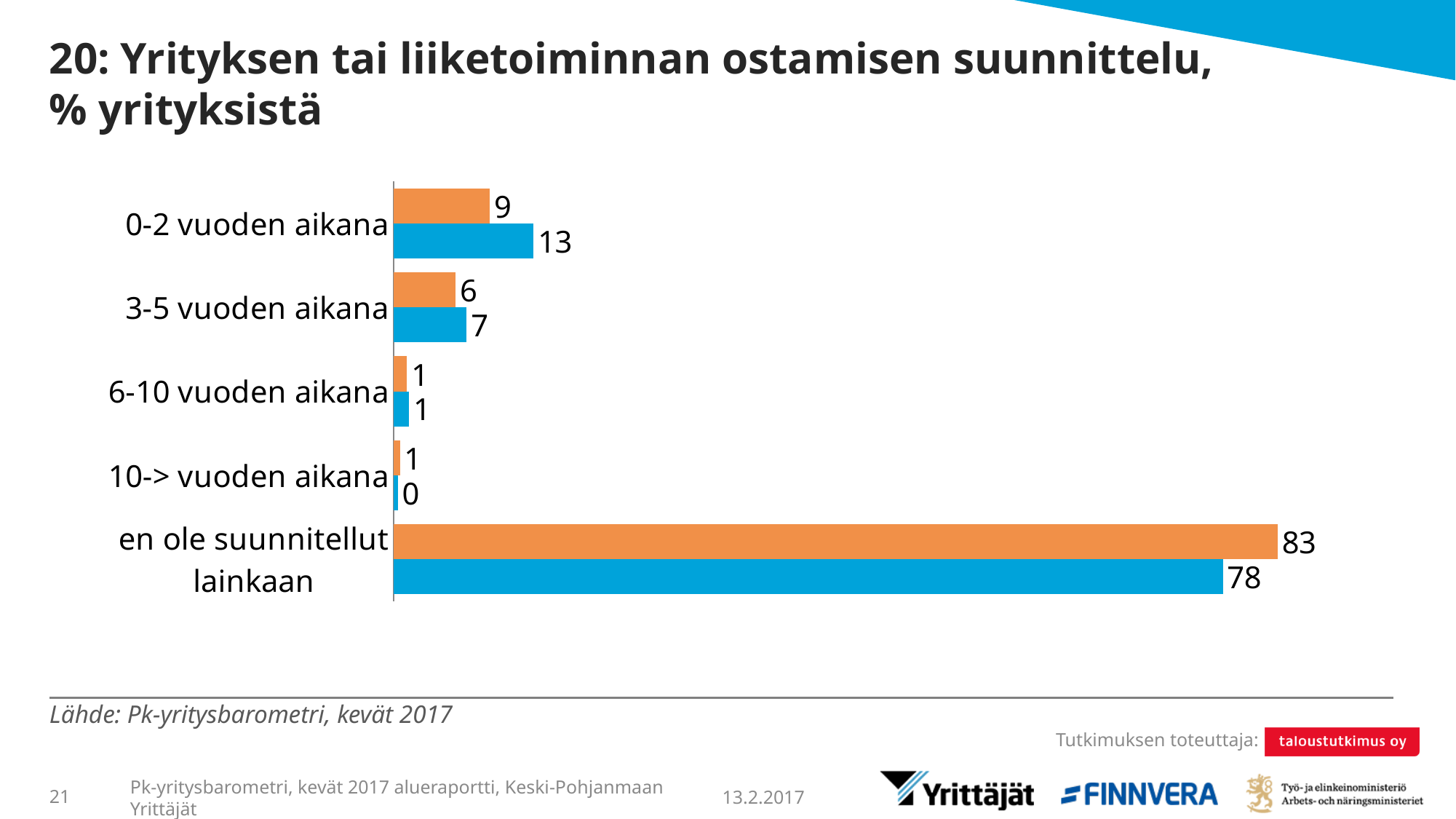
What type of chart is shown on the slide? bar chart What is the value of the blue bar for "0-2 vuoden aikana"? 13 Which category has the lowest value for the blue bars? 10-> vuoden aikana For "0-2 vuoden aikana", which bar is larger, the orange or the blue one? blue What is the value of the blue bar for "10-> vuoden aikana"? 0 What is the value of the blue bar for "3-5 vuoden aikana"? 7 What is the value of the orange bar for "0-2 vuoden aikana"? 9 What is the value of the orange bar for "en ole suunnitellut lainkaan"? 83 What is the difference between the orange and blue bars for "en ole suunnitellut lainkaan"? 5 How many categories are shown on the chart? 5 What is the title of the chart on the slide? 20: Yrityksen tai liiketoiminnan ostamisen suunnittelu, % yrityksistä Which category has the highest value for the blue bars? en ole suunnitellut lainkaan